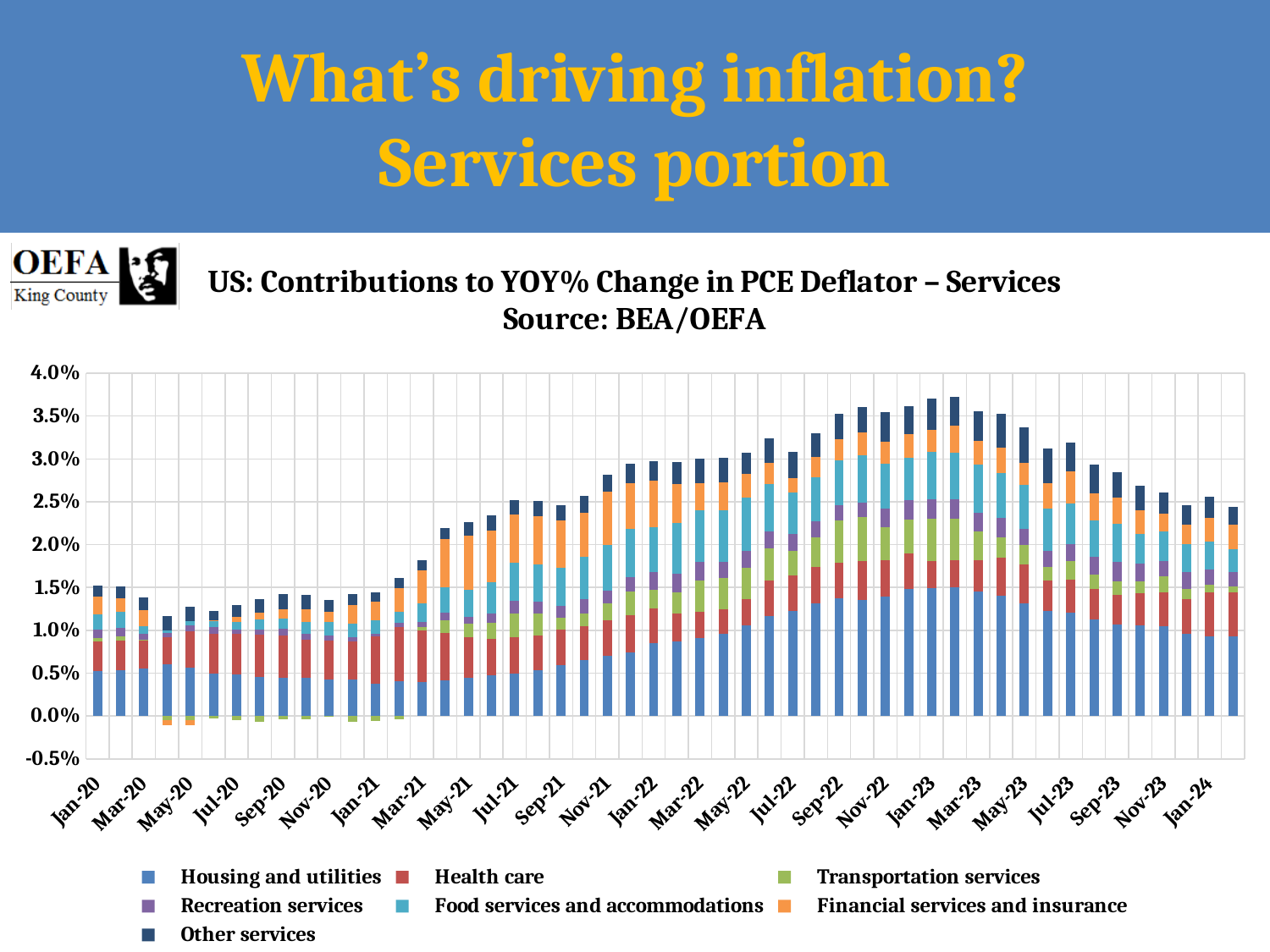
What source is cited for the chart? BEA/OEFA Which bar has the larger total, Jan-23 or Jan-24? Jan-23 Is the total value of the bar for Nov-21 greater or less than 2.5%? greater Is the total value of the bar for Mar-21 greater or less than 2.0%? less What kind of chart is shown on the slide? Stacked bar chart Is the total value of the bar for Jan-23 greater or less than 3.5%? greater Do the total bar heights generally rise or fall from Mar-23 to Jan-24? fall What is the title of the chart? US: Contributions to YOY% Change in PCE Deflator – Services Which bar has the larger total, Jan-20 or Jan-22? Jan-22 How many series does the legend list? 7